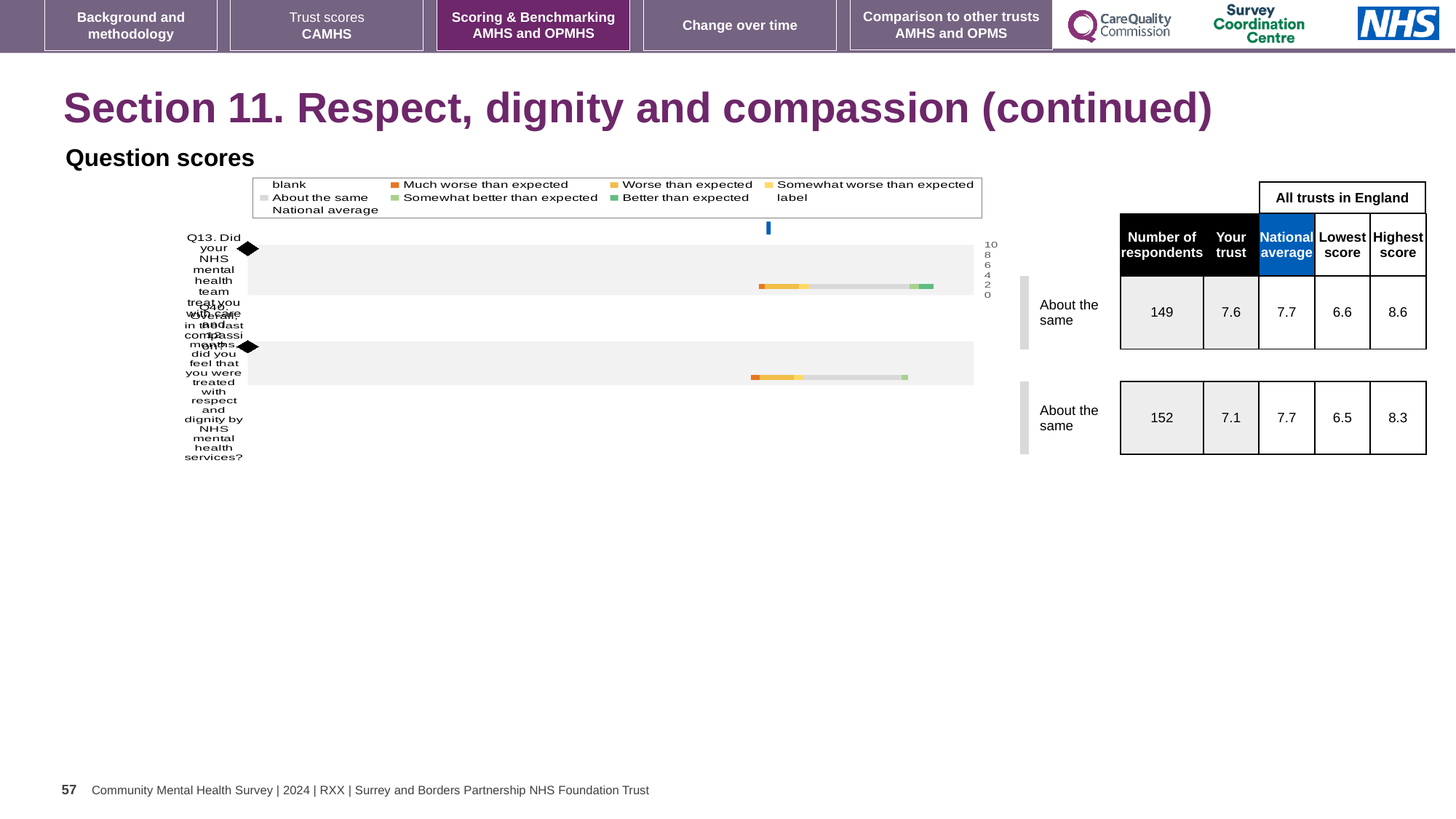
What benchmark category label is shown next to the chart for Q13? About the same What is the national average score shown for Q13? 7.7 How many respondents are listed for Q13? 149 What is the difference between the highest score and the lowest score for Q13? 2.0 How many respondents are listed for Q10? 152 What kind of chart is shown under 'Question scores'? bar chart Which question has the higher 'Your trust' score, Q13 or Q10? Q13 By how much is the national average higher than the trust's score for Q10? 0.6 What is the highest score across all trusts in England for Q10? 8.3 In the table beside the chart, what is the 'Your trust' score for Q10? 7.1 In the table beside the chart, what is the 'Your trust' score for Q13? 7.6 How many questions are plotted in the Question scores chart? 2